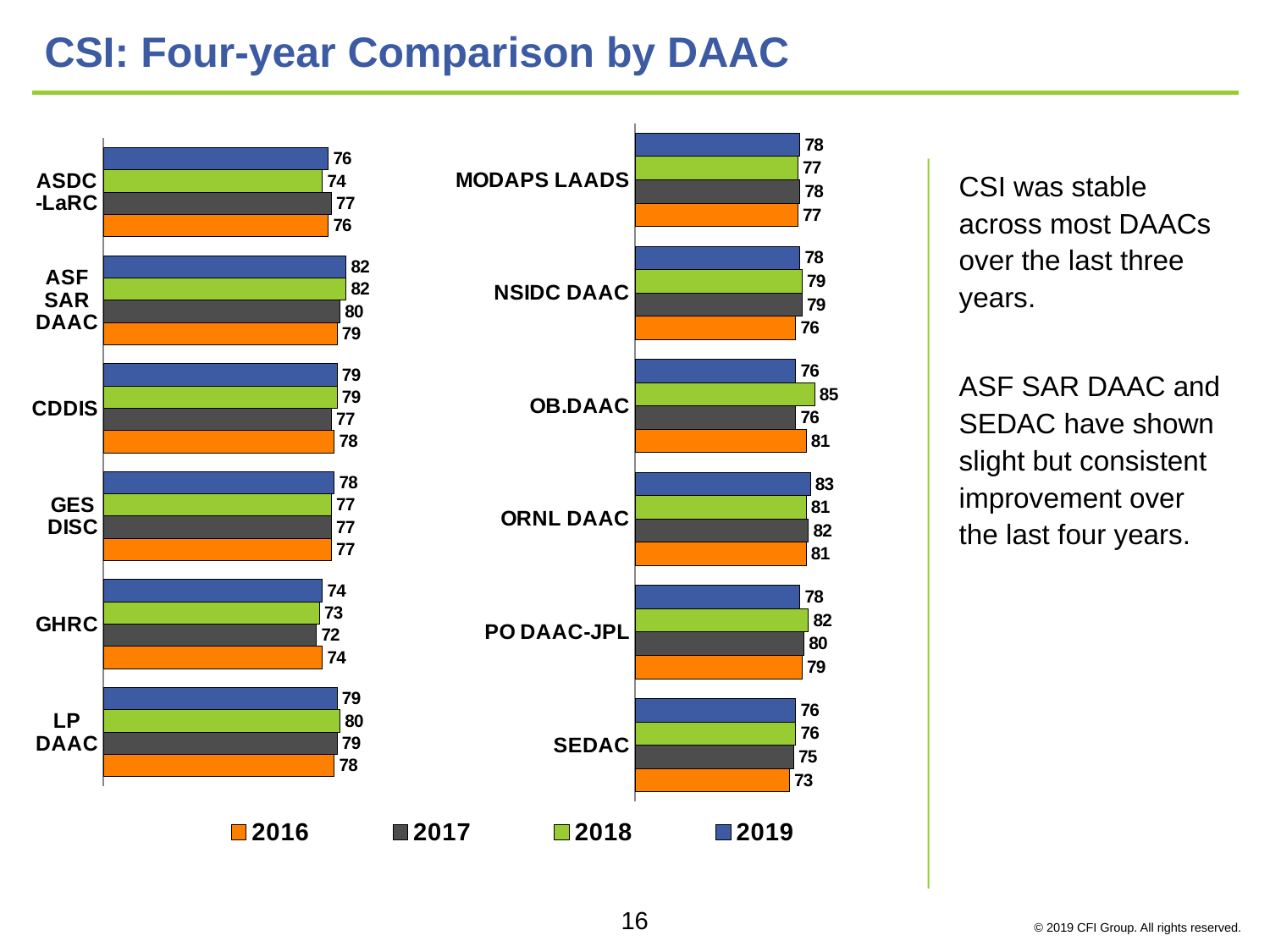
In the left chart, what is the 2019 value for ASF SAR DAAC? 82 How many DAACs are shown in the left chart? 6 In the left chart, which DAAC has the lowest 2018 value? GHRC In the right chart, what is the difference between the 2018 and 2019 values for OB.DAAC? 9 What type of chart is used on this slide? Bar chart In the right chart, which is larger for PO DAAC-JPL: the 2018 value or the 2019 value? 2018 In the right chart, what is the 2018 value for OB.DAAC? 85 In the right chart, what is the 2016 value for SEDAC? 73 In the left chart, what is the 2017 value for GHRC? 72 In the right chart, which DAAC has the highest 2019 value? ORNL DAAC In the left chart, what is the difference between the 2019 and 2016 values for ASF SAR DAAC? 3 How many series does the legend list? 4